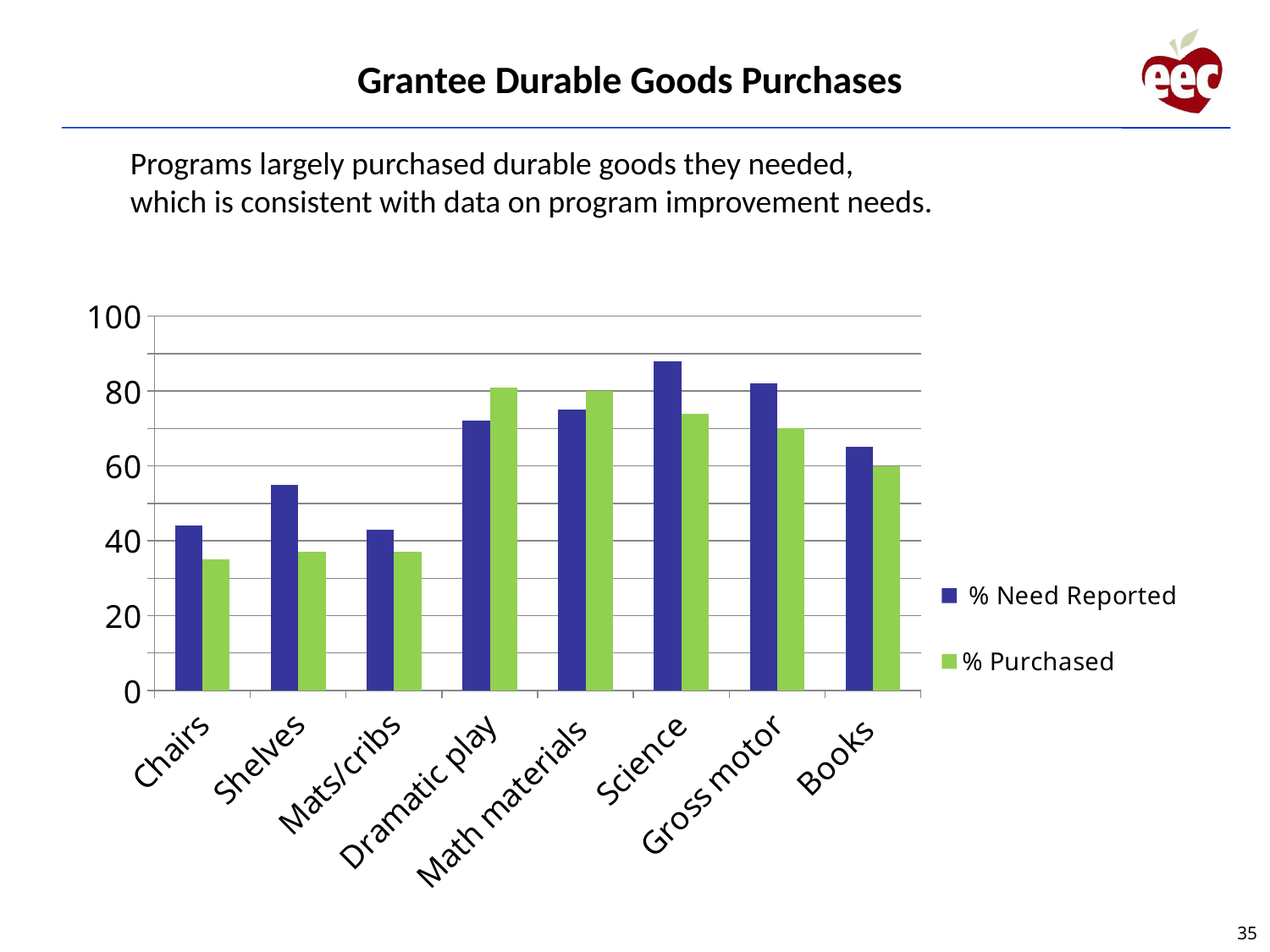
For Science, which is larger: % Need Reported or % Purchased? % Need Reported Which series is shown in green in the legend? % Purchased What kind of chart is shown on the slide? bar chart Which category has the highest % Need Reported? Science How many categories of durable goods are shown on the x axis? 8 Is the % Purchased value for Gross motor greater or less than 80? less For Dramatic play, which is larger: % Need Reported or % Purchased? % Purchased Is the % Need Reported value for Science greater or less than 80? greater Is the % Need Reported value for Books greater or less than 60? greater How many series does the legend list? 2 What is the title of the slide containing the chart? Grantee Durable Goods Purchases